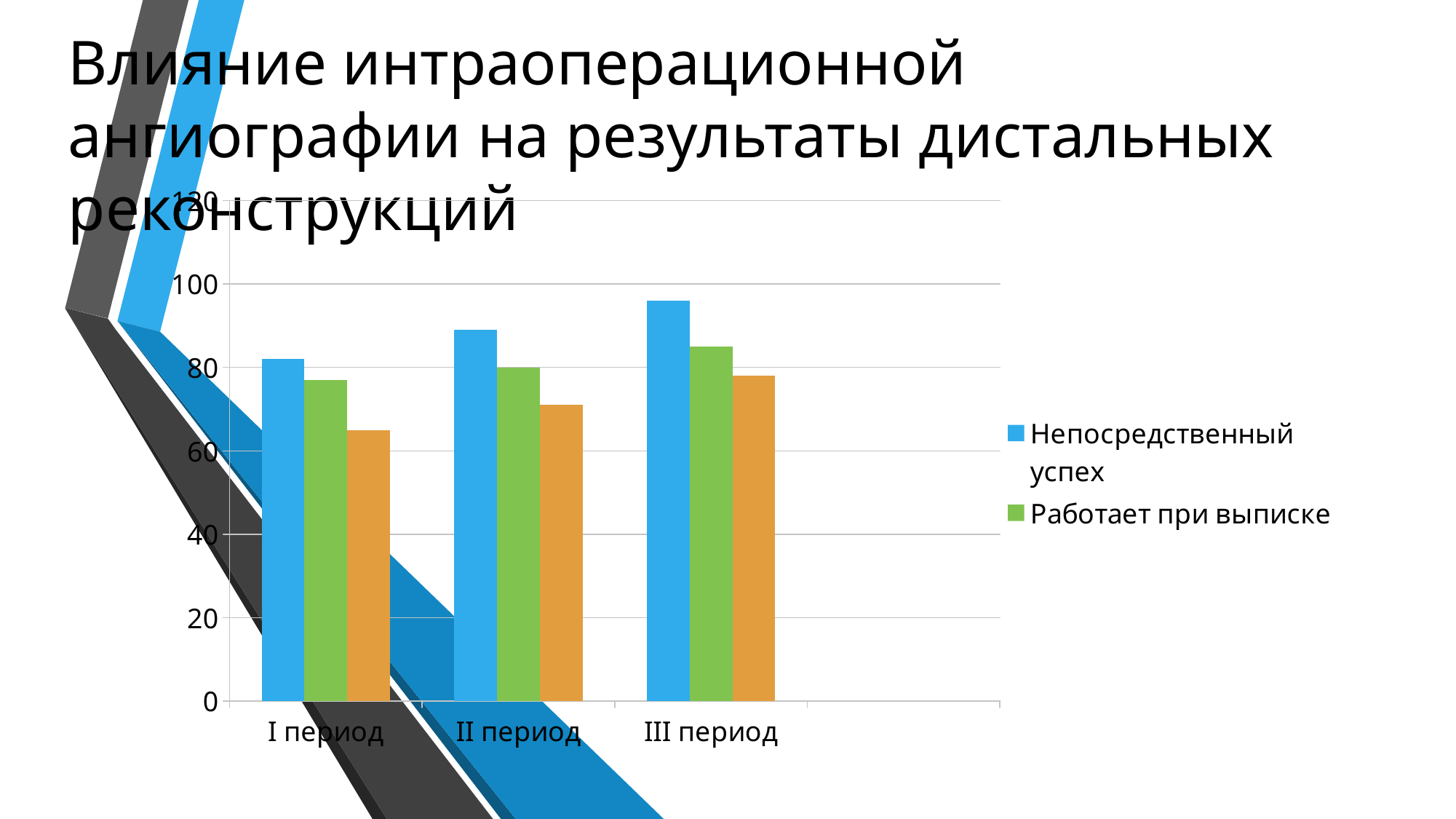
In I период, which is larger: Непосредственный успех or Работает при выписке? Непосредственный успех How many series does the legend list? 2 Is the value for Непосредственный успех in III период greater or less than 80? greater In which period is the value for Работает при выписке the highest? III период In which period is the value for Непосредственный успех the lowest? I период Is the value for Работает при выписке in I период greater or less than 80? less Is the value for Непосредственный успех in II период greater or less than 80? greater How many categories (periods) are shown on the x axis? 3 What colour are the bars for Работает при выписке? green Do the values for Непосредственный успех rise or fall from I период to III период? rise In which period is the value for Непосредственный успех the highest? III период What kind of chart is shown on the slide? bar chart